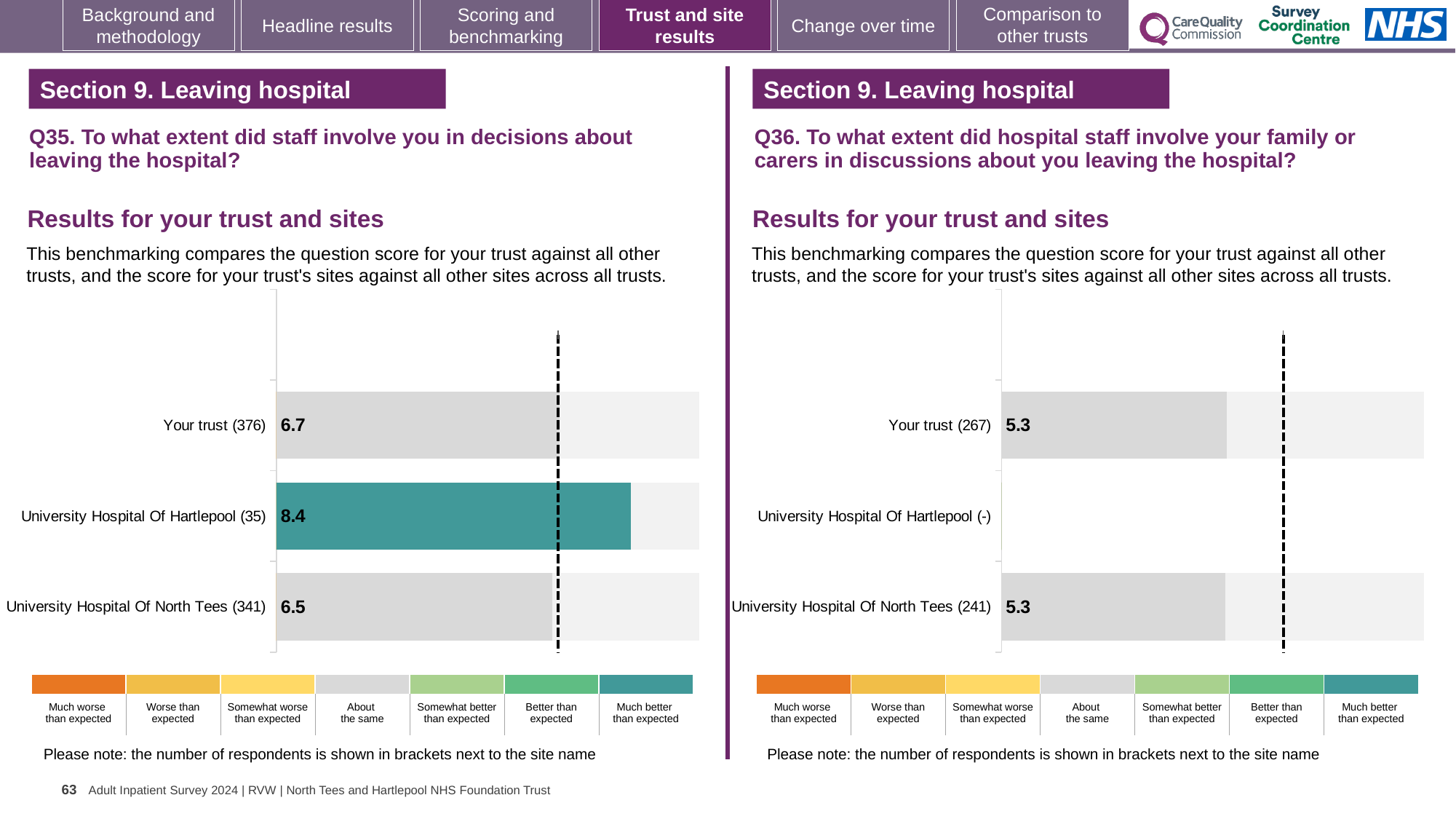
In the Q36 chart on the right, what is the score for University Hospital Of North Tees? 5.3 In the Q35 chart on the left, which site or trust has the lowest score? University Hospital Of North Tees In the Q35 chart on the left, what is the score for University Hospital Of North Tees? 6.5 In the Q35 chart on the left, which benchmark category does the colour of the University Hospital Of Hartlepool bar correspond to? Much better than expected In the Q35 chart on the left, what is the score for Your trust? 6.7 What type of chart is used in the Q35 chart on the left? Bar chart In the Q35 chart on the left, what is the difference between the scores for University Hospital Of Hartlepool and University Hospital Of North Tees? 1.9 In the Q36 chart on the right, how many respondents are shown for Your trust? 267 In the Q35 chart on the left, which site or trust has the highest score? University Hospital Of Hartlepool In the Q35 chart on the left, how many respondents are shown for University Hospital Of Hartlepool? 35 In the Q36 chart on the right, what is the score for Your trust? 5.3 In the Q35 chart on the left, what is the score for University Hospital Of Hartlepool? 8.4